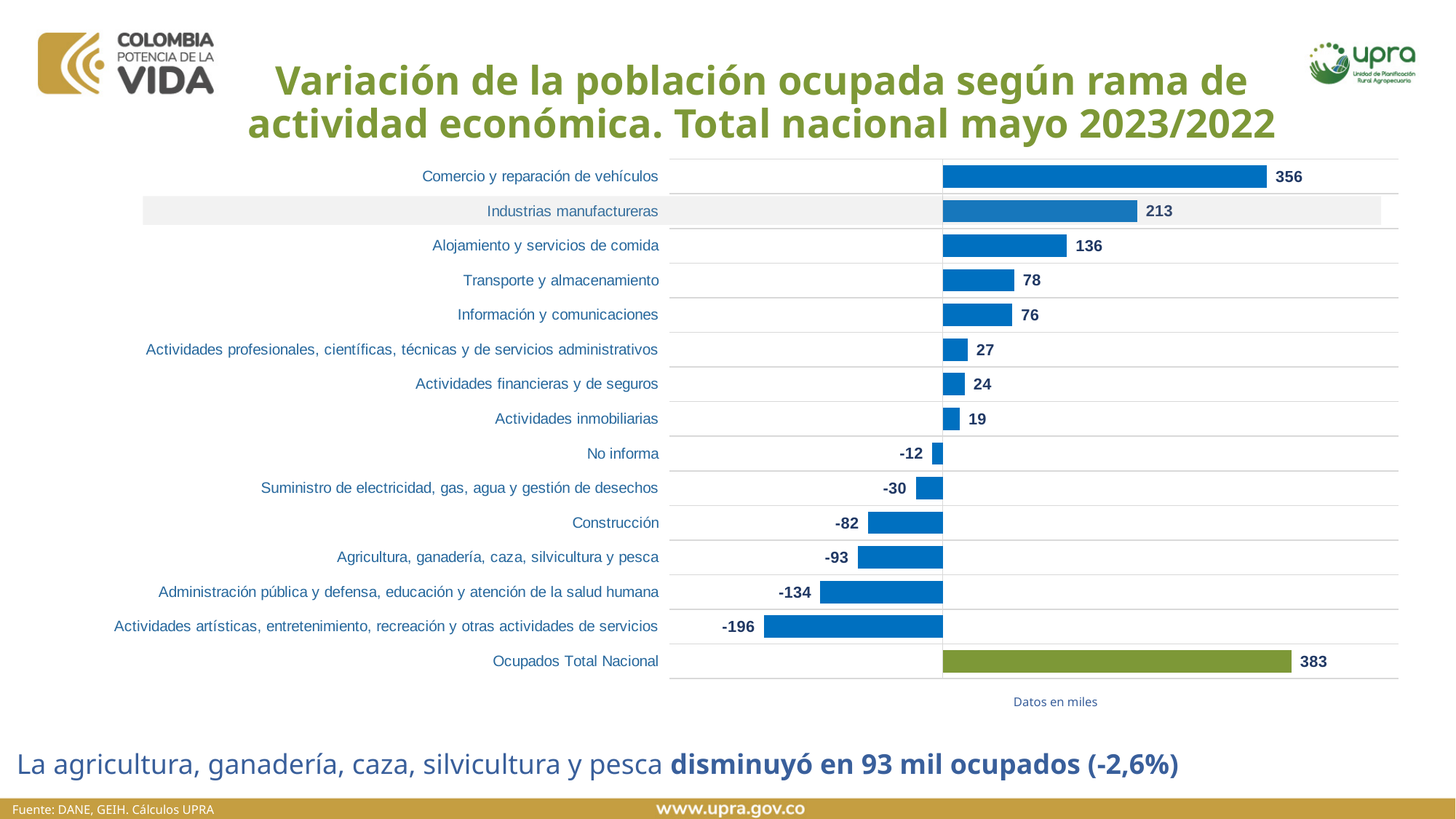
What unit note is shown below the chart? Datos en miles What is the value for Comercio y reparación de vehículos? 356 What is the difference between the values for Construcción and Suministro de electricidad, gas, agua y gestión de desechos? 52 Which category has the highest value? Ocupados Total Nacional What is the difference between the values for Comercio y reparación de vehículos and Industrias manufactureras? 143 What is the value for Agricultura, ganadería, caza, silvicultura y pesca? -93 Which is larger, the value for Transporte y almacenamiento or Información y comunicaciones? Transporte y almacenamiento What is the value for Actividades artísticas, entretenimiento, recreación y otras actividades de servicios? -196 What kind of chart is shown on the slide? Bar chart What is the value for Ocupados Total Nacional? 383 Which category has the lowest value? Actividades artísticas, entretenimiento, recreación y otras actividades de servicios How many categories are shown in the chart? 15